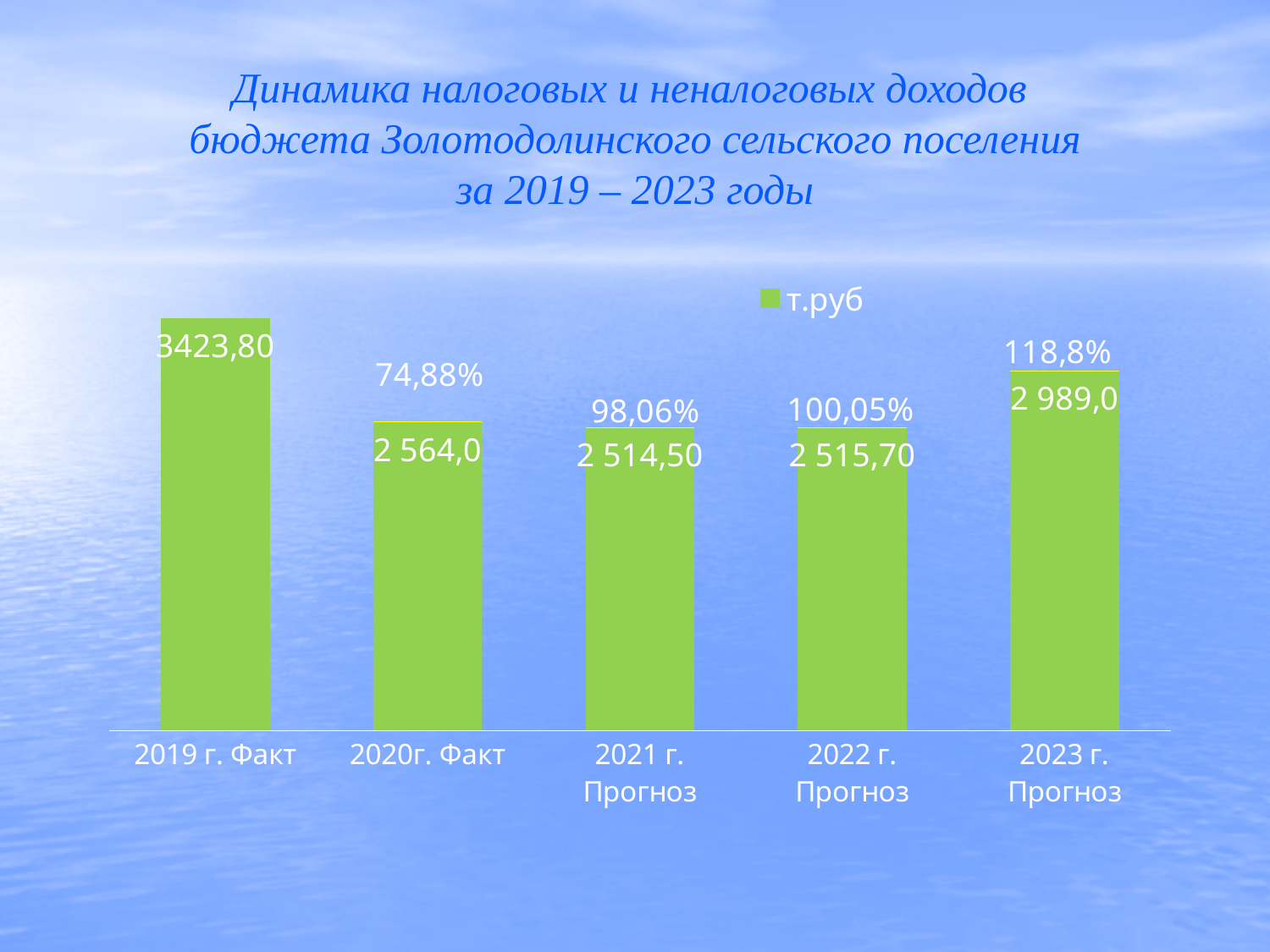
What is the value for 2020г. Факт? 2 564,0 How many categories are shown on the x axis? 5 What is the value for 2021 г. Прогноз? 2 514,50 What is the value for 2019 г. Факт? 3423,80 What kind of chart is shown on the slide? Bar chart What percentage is shown above the bar for 2023 г. Прогноз? 118,8% Which category has the highest value? 2019 г. Факт What is the value for 2023 г. Прогноз? 2 989,0 Which is larger, the value for 2019 г. Факт or 2023 г. Прогноз? 2019 г. Факт What percentage is shown above the bar for 2022 г. Прогноз? 100,05% What series name does the legend show? т.руб What is the difference between the values for 2019 г. Факт and 2020г. Факт? 859,80